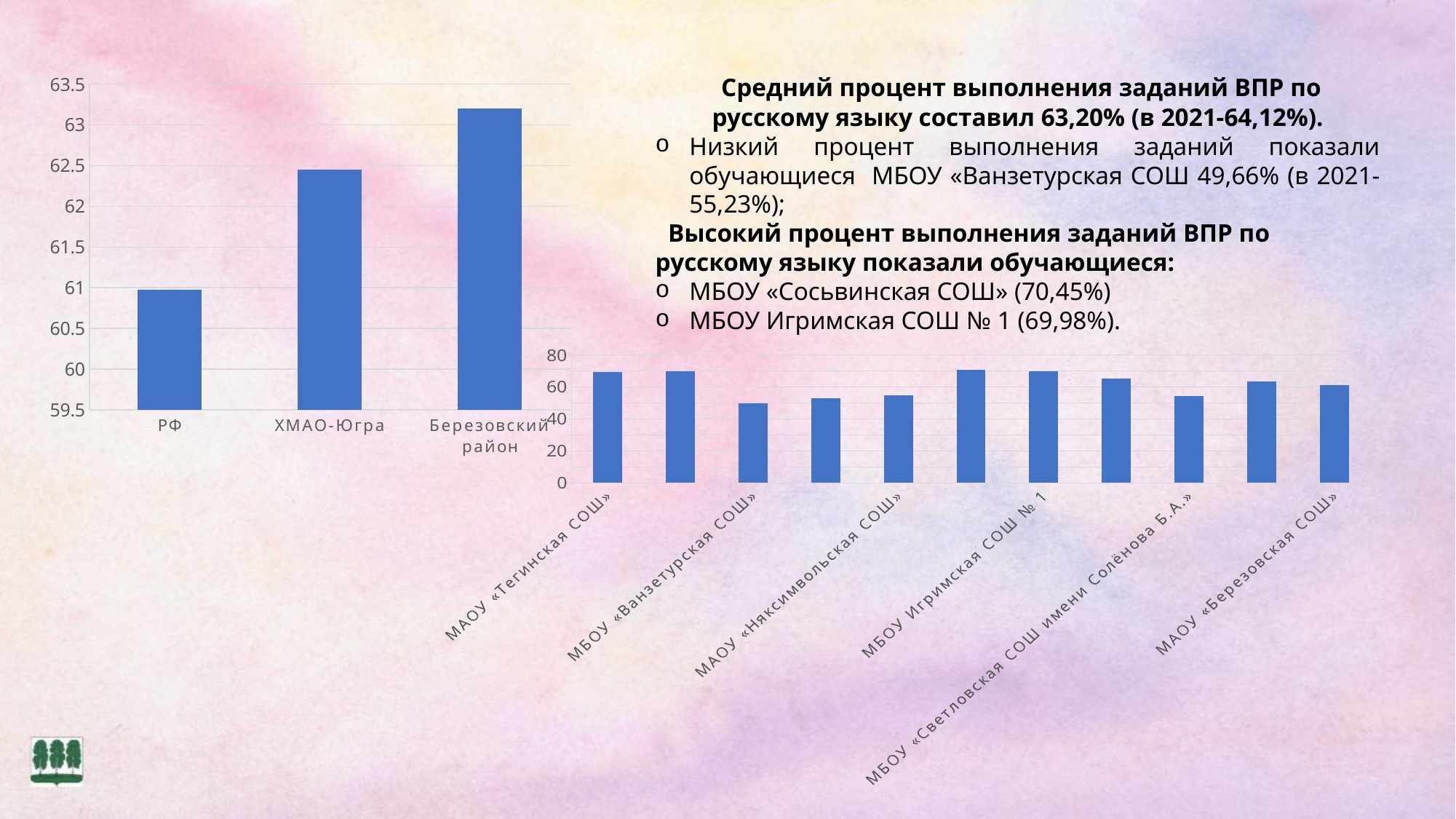
On the left chart, is the value for ХМАО-Югра greater or less than 62? greater On the left chart, which is larger, the value for ХМАО-Югра or the value for РФ? ХМАО-Югра On the left chart, how many categories are shown? 3 On the right chart, is the value for МБОУ Игримская СОШ № 1 greater or less than 60? greater On the left chart, which category has the lowest value? РФ On the right chart, which is larger, the value for МБОУ Игримская СОШ № 1 or the value for МБОУ «Ванзетурская СОШ»? МБОУ Игримская СОШ № 1 On the left chart, is the value for РФ greater or less than 61.5? less On the left chart, which category has the highest value? Березовский район On the right chart, how many bars are plotted? 11 What kind of chart is the left chart? bar chart